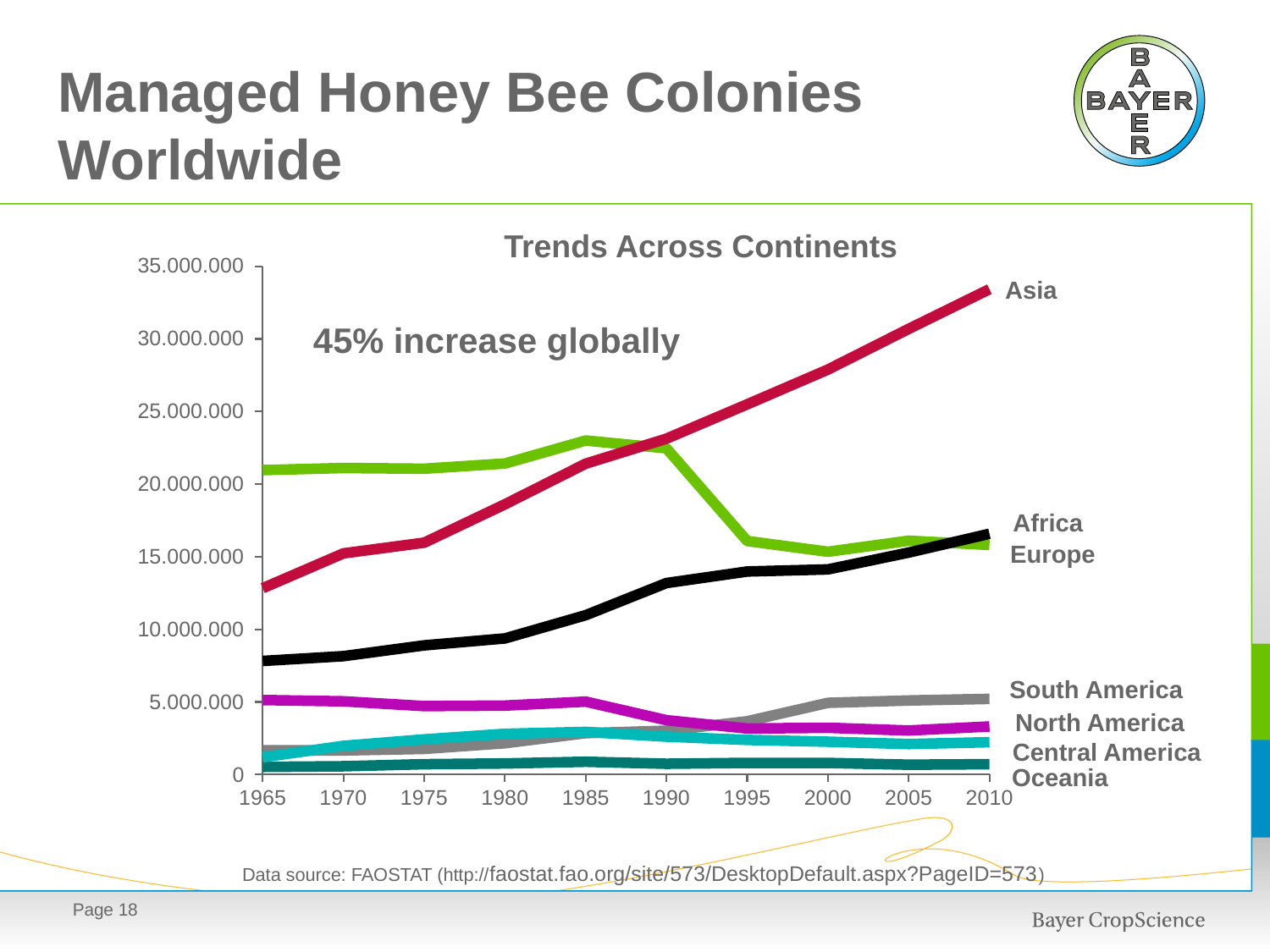
Is the value for Europe in 1985 greater or less than 20.000.000? greater What kind of chart is shown under the title 'Trends Across Continents'? line chart How many year points are marked along the x axis of the chart? 10 Which continent has the highest number of colonies in 2010? Asia How many continent series are labeled on the chart? 7 Is the value for Africa in 1965 greater or less than 10.000.000? less Which is larger in 1965, the value for Europe or the value for Asia? Europe Does the Asia line rise or fall from 1965 to 2010? rise Is the value for Asia in 2010 greater or less than 30.000.000? greater Which continent has the lowest number of colonies in 2010? Oceania Does the Europe line rise or fall between 1990 and 1995? fall Which continent had the highest number of colonies in 1965? Europe